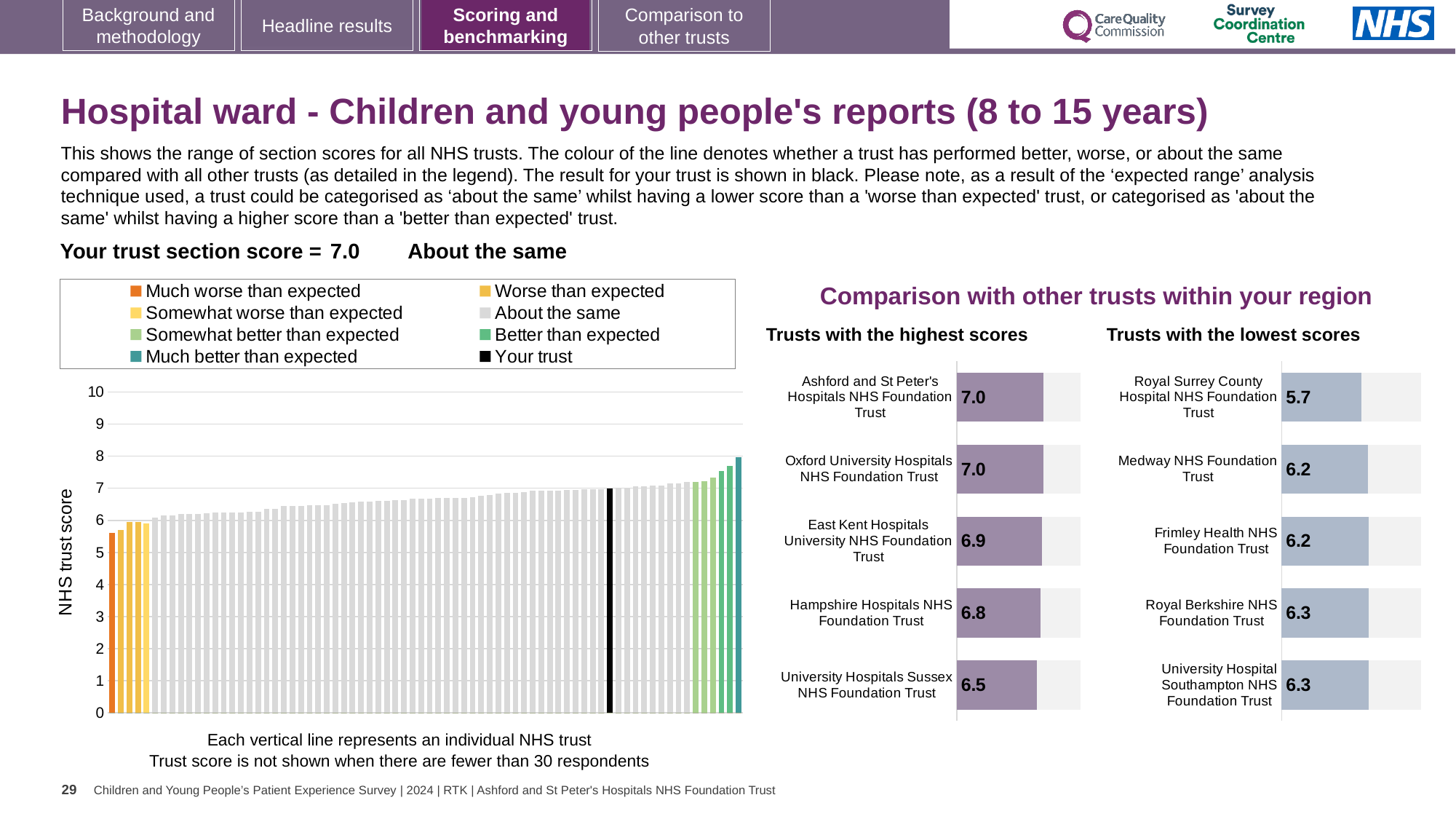
In the 'Trusts with the highest scores' chart, which trust has the lowest score? University Hospitals Sussex NHS Foundation Trust In the 'Trusts with the highest scores' chart, what is the difference between the scores of Ashford and St Peter's Hospitals NHS Foundation Trust and University Hospitals Sussex NHS Foundation Trust? 0.5 How many trusts are shown in the 'Trusts with the highest scores' chart? 5 In the NHS trust score chart on the left, what colour does the legend use for 'Your trust'? black In the NHS trust score chart on the left, is the value of the leftmost (orange) bar greater or less than 6? less In the 'Trusts with the lowest scores' chart, which trust has the lowest score? Royal Surrey County Hospital NHS Foundation Trust How many entries does the legend of the NHS trust score chart on the left list? 8 Comparing the 'Trusts with the highest scores' and 'Trusts with the lowest scores' charts, which has the larger score: Hampshire Hospitals NHS Foundation Trust or Royal Berkshire NHS Foundation Trust? Hampshire Hospitals NHS Foundation Trust In the NHS trust score chart on the left, do the bar values rise or fall from left to right? rise In the 'Trusts with the lowest scores' chart, what is the score for Royal Surrey County Hospital NHS Foundation Trust? 5.7 What kind of chart is the NHS trust score chart on the left of the slide? bar chart In the 'Trusts with the highest scores' chart, what is the score for East Kent Hospitals University NHS Foundation Trust? 6.9